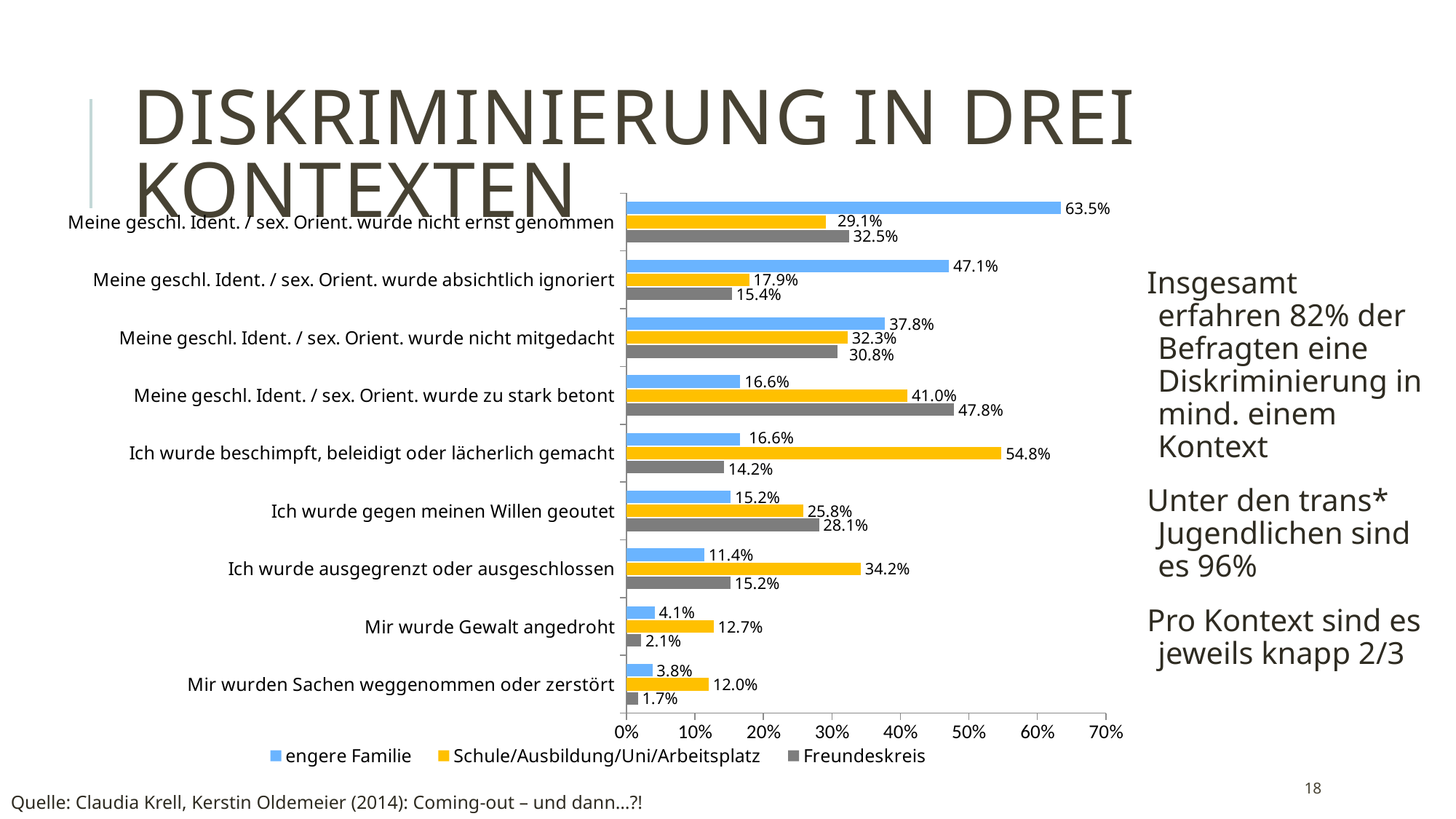
What is the value for "Freundeskreis" for "Meine geschl. Ident. / sex. Orient. wurde zu stark betont"? 47.8% How many categories are shown on the chart? 9 Which series is shown in yellow in the legend? Schule/Ausbildung/Uni/Arbeitsplatz What kind of chart is shown on the slide? bar chart What is the value for "Schule/Ausbildung/Uni/Arbeitsplatz" for "Ich wurde beschimpft, beleidigt oder lächerlich gemacht"? 54.8% For "Ich wurde ausgegrenzt oder ausgeschlossen", which is larger: the value for "engere Familie" or for "Schule/Ausbildung/Uni/Arbeitsplatz"? Schule/Ausbildung/Uni/Arbeitsplatz How many series does the legend list? 3 What is the difference between the "engere Familie" and "Freundeskreis" values for "Meine geschl. Ident. / sex. Orient. wurde absichtlich ignoriert"? 31.7% Which category has the lowest value for "Freundeskreis"? Mir wurden Sachen weggenommen oder zerstört Which category has the highest value for "engere Familie"? Meine geschl. Ident. / sex. Orient. wurde nicht ernst genommen What is the value for "engere Familie" for "Meine geschl. Ident. / sex. Orient. wurde nicht ernst genommen"? 63.5% Is the "Schule/Ausbildung/Uni/Arbeitsplatz" value for "Meine geschl. Ident. / sex. Orient. wurde zu stark betont" greater or less than 30%? greater